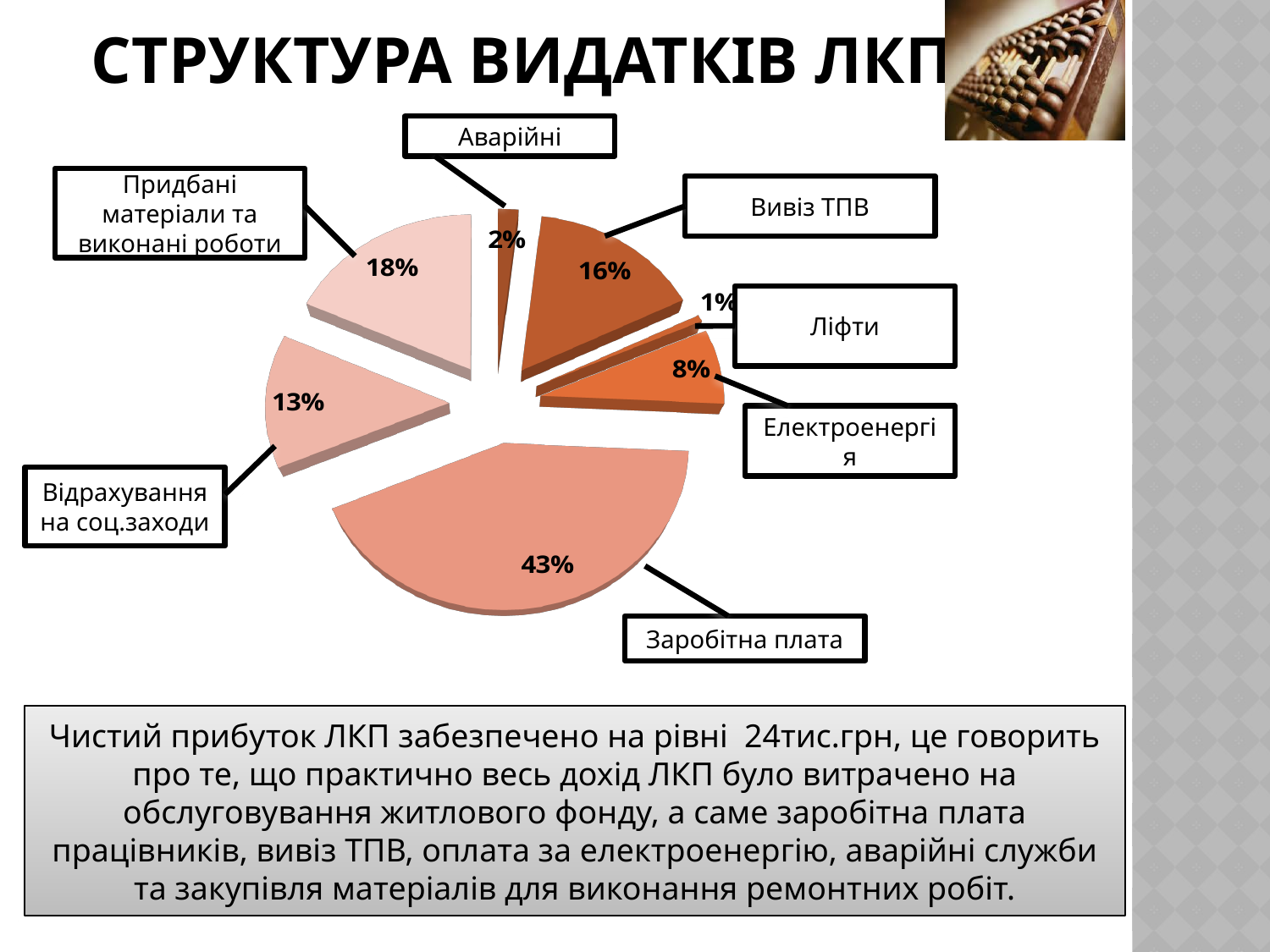
How many categories are shown in the pie chart? 7 What percentage is shown for Вивіз ТПВ? 16% What share of expenditures does Заробітна плата account for? 43% Which is larger, the share for Вивіз ТПВ or the share for Відрахування на соц.заходи? Вивіз ТПВ What is the title of the slide containing the chart? СТРУКТУРА ВИДАТКІВ ЛКП Which category has the smallest share of the pie? Ліфти What percentage does Відрахування на соц.заходи represent? 13% Which category has the largest share of the pie? Заробітна плата What share is labelled for Електроенергія? 8% What type of chart is shown on the slide? Pie chart What percentage is shown for Придбані матеріали та виконані роботи? 18% What is the difference in percentage points between Заробітна плата and Придбані матеріали та виконані роботи? 25